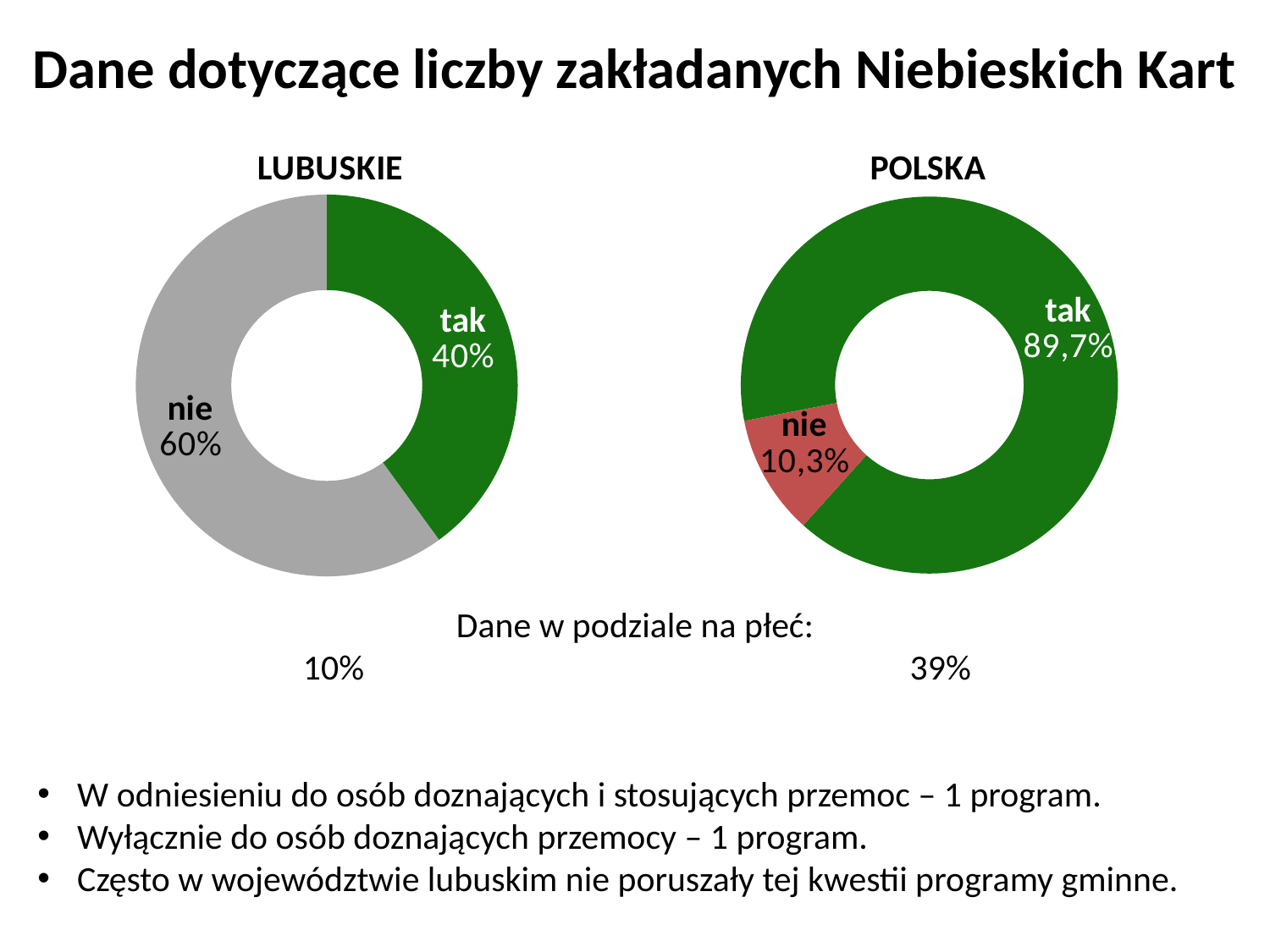
In the POLSKA chart, which category has the smallest share? nie In the POLSKA chart, what is the value for "nie"? 10,3% In the POLSKA chart, what is the difference between "tak" and "nie"? 79,4% What kind of chart is the LUBUSKIE chart? Doughnut (pie) chart In the LUBUSKIE chart, what is the value for "tak"? 40% In the POLSKA chart, what is the value for "tak"? 89,7% How many categories does the POLSKA chart show? 2 In the LUBUSKIE chart, what is the value for "nie"? 60% In the LUBUSKIE chart, what is the difference between "nie" and "tak"? 20% Which is larger: "tak" in the LUBUSKIE chart or "tak" in the POLSKA chart? tak in POLSKA In the LUBUSKIE chart, which category has the largest share? nie In the POLSKA chart, what colour is the "nie" slice? Red